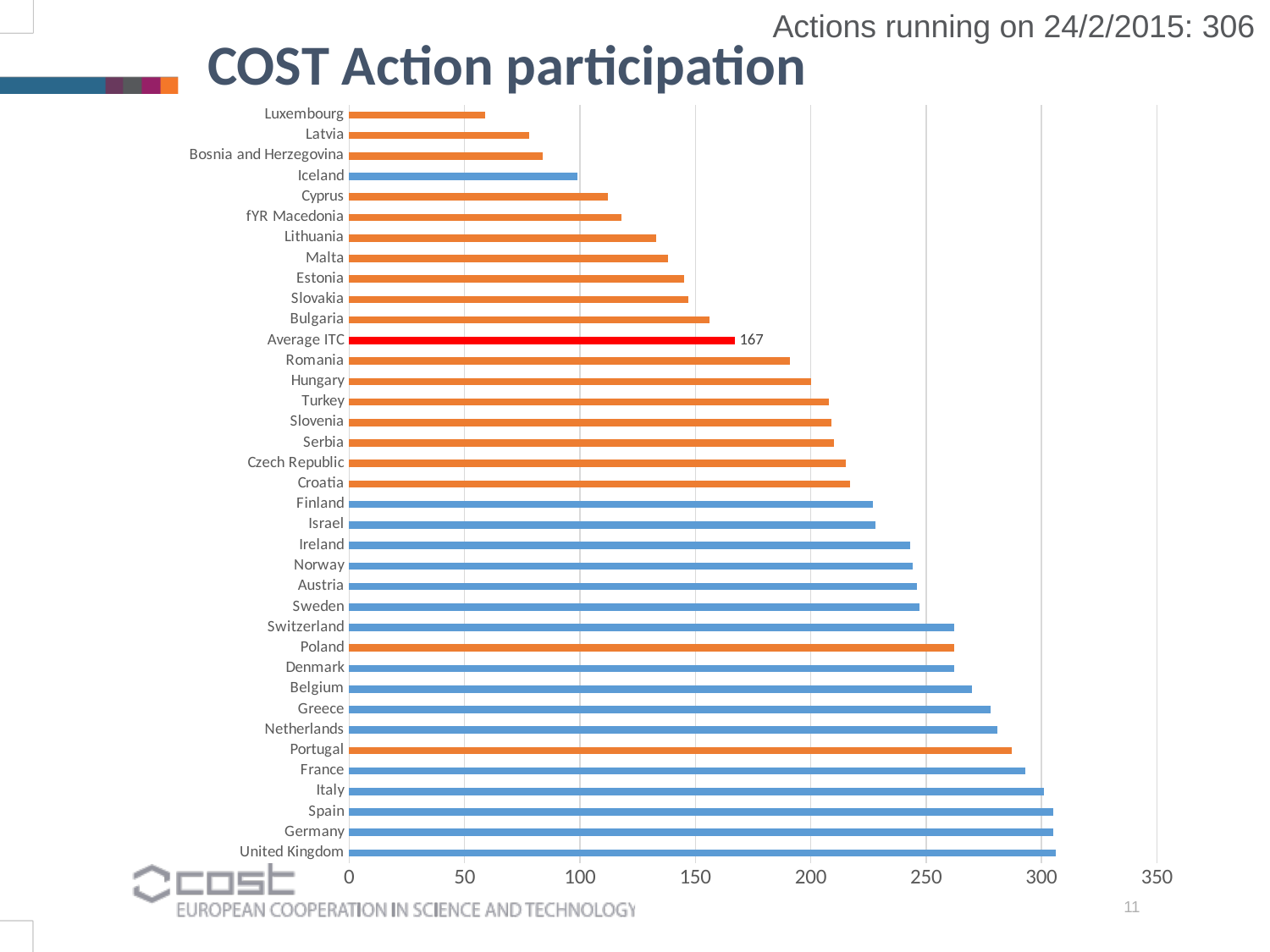
Which has a larger value, Croatia or Finland? Finland What type of chart is shown on the slide? bar chart How many categories (bars) are plotted in the chart? 37 Which category has the lowest value in the chart? Luxembourg Is the value for Portugal greater or less than 250? greater Which has a larger value, Italy or France? Italy What colour is the bar for Average ITC? red What is the value shown for Average ITC? 167 Is the value for Luxembourg greater or less than 100? less Is the value for France greater or less than 300? less